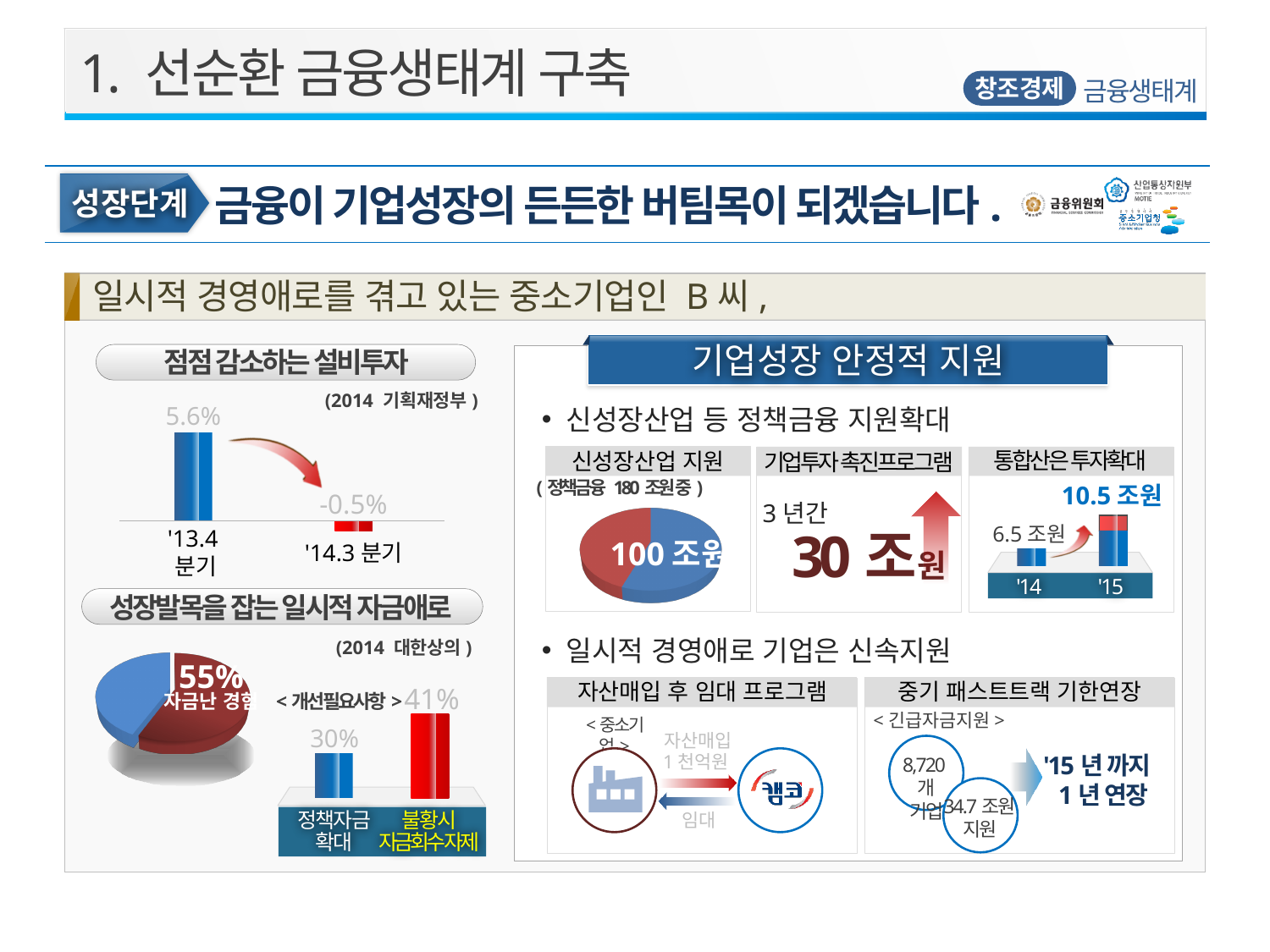
In the '점점 감소하는 설비투자' chart, what is the value for '14.3분기? -0.5% In the '개선필요사항' bar chart, which category has the higher value? 불황시 자금회수자제 In the '점점 감소하는 설비투자' chart, what is the difference between the '13.4분기 and '14.3분기 values? 6.1 percentage points In the '점점 감소하는 설비투자' chart, do the values rise or fall from '13.4분기 to '14.3분기? fall What kind of chart is shown under '점점 감소하는 설비투자'? bar chart In the '점점 감소하는 설비투자' chart, what is the value for '13.4분기? 5.6% In the '통합산은 투자확대' chart, what is the value for '15? 10.5 조원 In the '개선필요사항' bar chart, what is the value for '정책자금 확대'? 30% In the '통합산은 투자확대' chart, what is the difference between the '15 and '14 values? 4 조원 In the '개선필요사항' bar chart, what is the difference between '불황시 자금회수자제' and '정책자금 확대'? 11 percentage points In the pie chart under '성장발목을 잡는 일시적 자금애로', what share of companies experienced 자금난? 55% In the '개선필요사항' bar chart, what is the value for '불황시 자금회수자제'? 41%